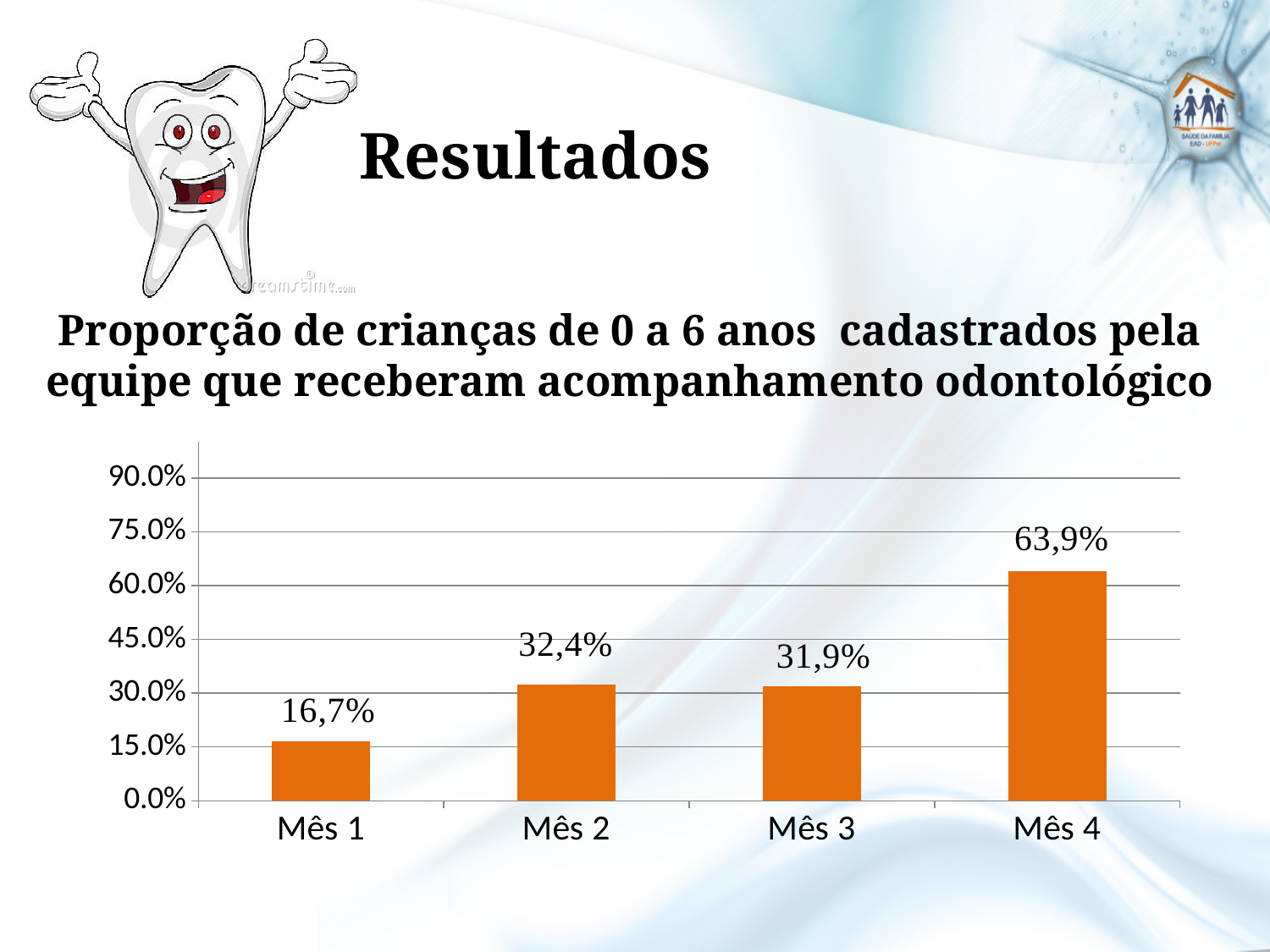
What is the value for Mês 1? 16,7% What is the value for Mês 4? 63,9% Which month has the lowest value? Mês 1 What is the value for Mês 2? 32,4% Which is larger, the value for Mês 2 or the value for Mês 3? Mês 2 What kind of chart is shown on the slide? bar chart What is the value for Mês 3? 31,9% Which month has the highest value? Mês 4 Is the value for Mês 4 greater or less than 60.0%? greater What is the difference between the values for Mês 4 and Mês 1? 47,2% Overall, do the values rise or fall from Mês 1 to Mês 4? rise How many months are shown on the x axis? 4